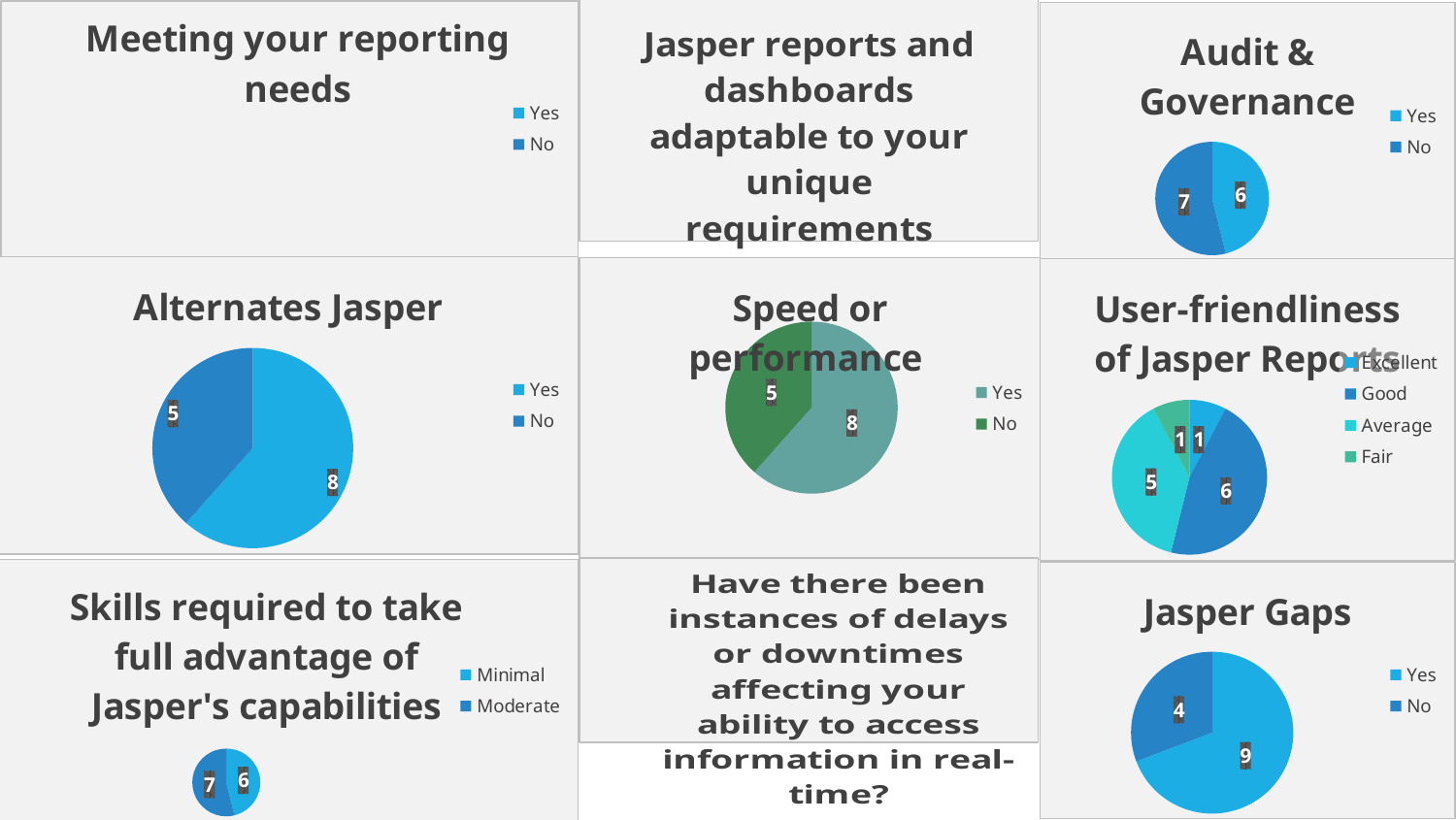
In the "Audit & Governance" chart, what is the value for No? 7 In the "User-friendliness of Jasper Reports" chart, which category has the highest value? Good In the "User-friendliness of Jasper Reports" chart, how many categories does the legend list? 4 In the "Speed or performance" chart, which is larger, Yes or No? Yes In the "Jasper Gaps" chart, what is the value for Yes? 9 What kind of chart is used in the "Skills required to take full advantage of Jasper's capabilities" panel? Pie chart In the "Alternates Jasper" chart, what is the value for Yes? 8 In the "Speed or performance" chart, what is the value for No? 5 In the "Alternates Jasper" chart, what is the difference between Yes and No? 3 In the "Audit & Governance" chart, what is the value for Yes? 6 In the "User-friendliness of Jasper Reports" chart, what is the value for Good? 6 In the "Jasper Gaps" chart, what share of the pie is No? 4 of 13